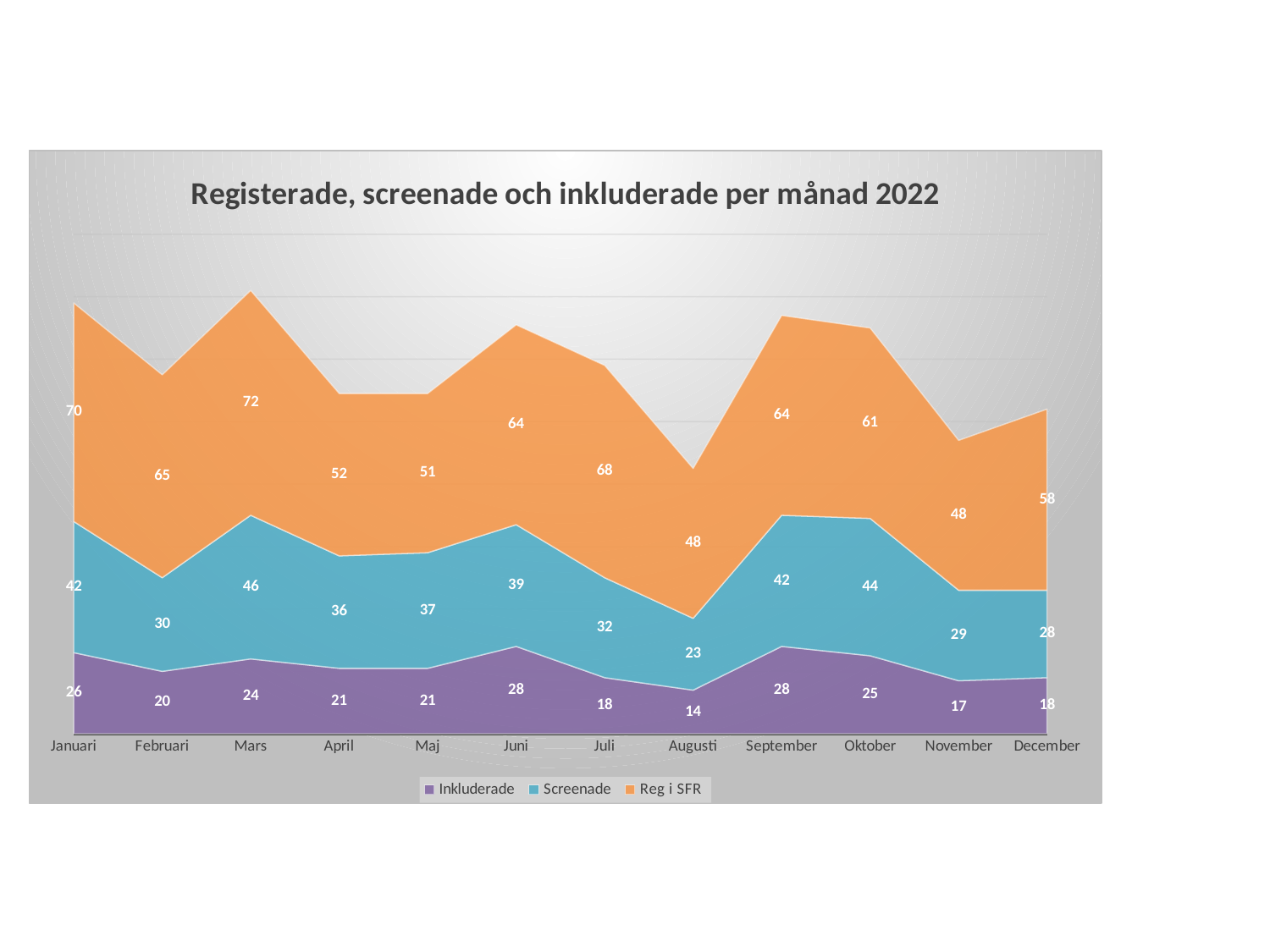
What is the difference between the Reg i SFR values for Januari and Februari? 5 How many months are shown on the x axis? 12 How many series does the legend list? 3 Which month has the highest value for Reg i SFR? Mars What is the value for Inkluderade in Augusti? 14 What is the value for Screenade in Oktober? 44 Which month has the lowest value for Screenade? Augusti What is the value for Reg i SFR in Mars? 72 Which is larger, the Screenade value for Mars or for September? Mars Which month has the lowest value for Inkluderade? Augusti What is the total of the three stacked values for December? 104 What kind of chart is shown on the slide? Stacked area chart